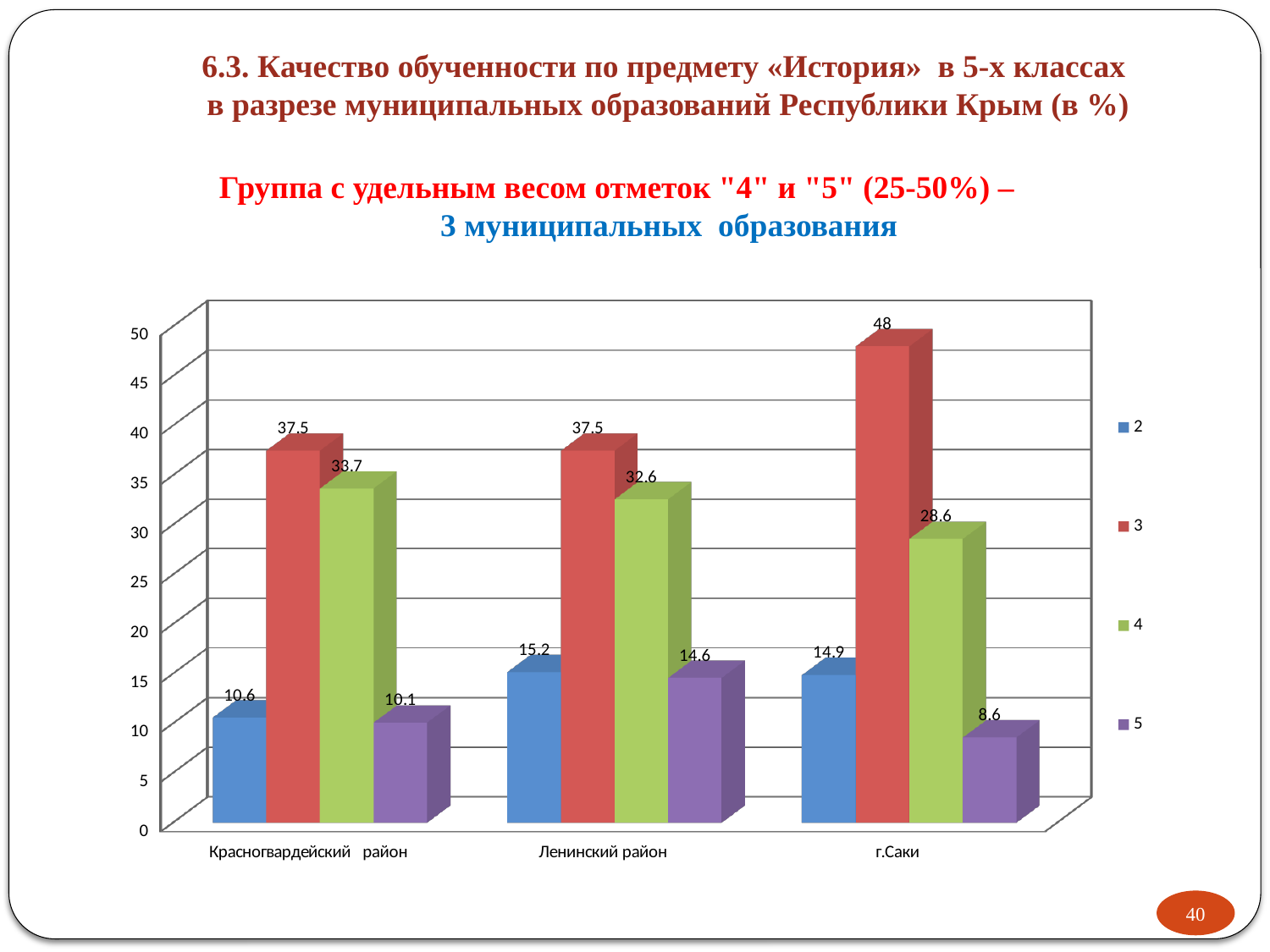
Which colour represents series "5" in the legend? Purple Which category has the highest value for series "3"? г.Саки What kind of chart is shown on the slide? Bar chart How many categories are shown on the x axis? 3 What is the value for series "2" in Ленинский район? 15.2 How many series does the legend list? 4 Which is larger: the series "4" value in Красногвардейский район or in Ленинский район? Красногвардейский район What is the value for series "3" in г.Саки? 48 What is the value for series "5" in г.Саки? 8.6 What is the difference between the series "3" value and the series "4" value in г.Саки? 19.4 What is the value for series "4" in Красногвардейский район? 33.7 Which category has the lowest value for series "5"? г.Саки